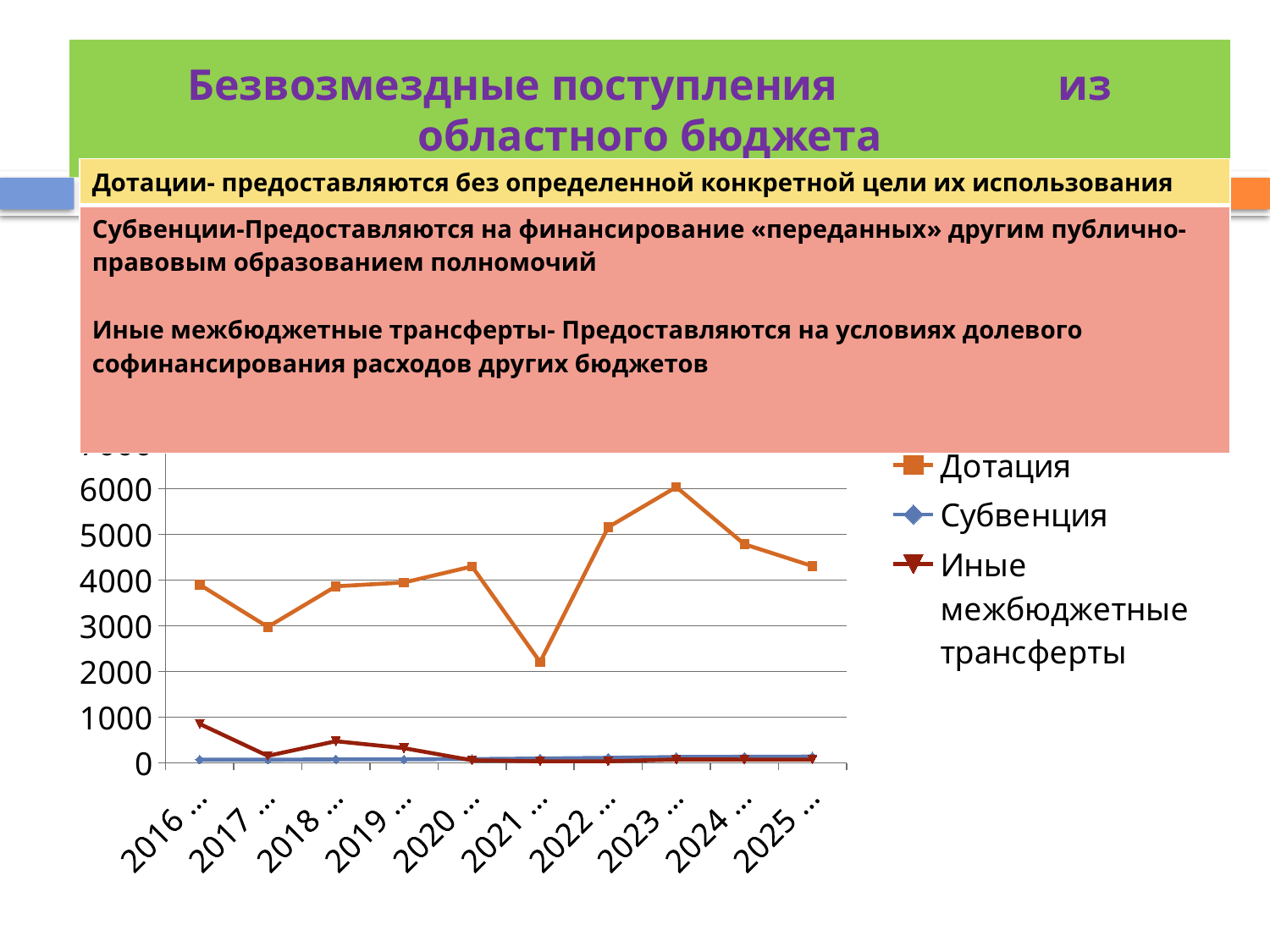
Which is larger: the Дотация value in 2023 or in 2024? 2023 In which year does the Дотация series reach its lowest value? 2021 Which series in the chart is drawn in orange? Дотация In which year does the Дотация series reach its highest value? 2023 Is the value of Дотация in 2021 greater or less than 3000? less Is the value of Дотация in 2016 greater or less than 3000? greater How many years are plotted along the x axis of the chart? 10 Is the value of Дотация in 2023 greater or less than 5000? greater What kind of chart is shown on the slide? line chart Does the Иные межбюджетные трансферты series rise or fall from 2016 to 2020? fall How many series does the chart legend list? 3